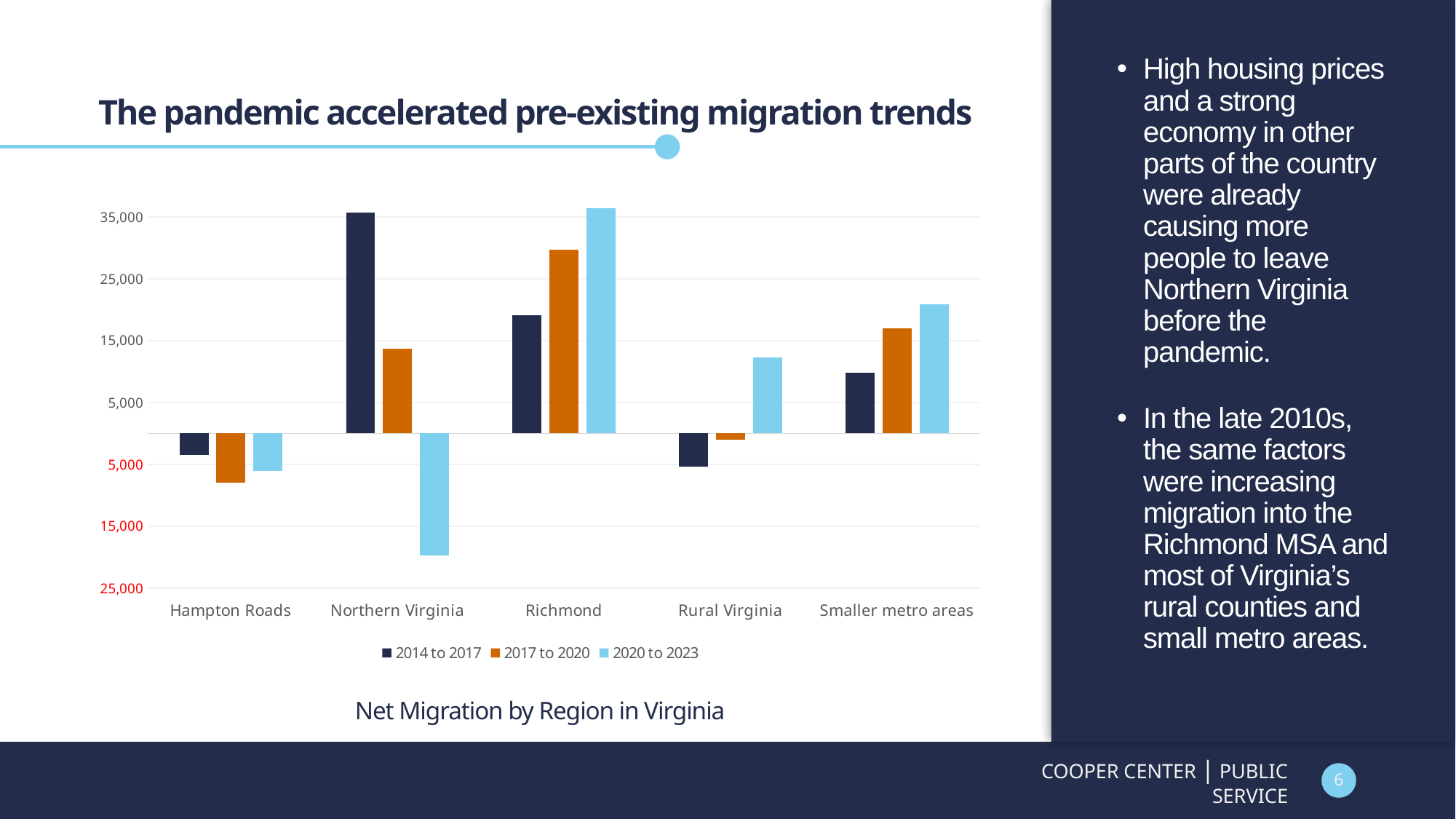
Which region has the lowest value for the 2020 to 2023 series? Northern Virginia What is the title shown below the chart? Net Migration by Region in Virginia Is the 2017 to 2020 value for Richmond greater or less than 25,000? greater Which region has the highest value for the 2014 to 2017 series? Northern Virginia How many series does the chart legend list? 3 Is the 2014 to 2017 value for Northern Virginia greater or less than 25,000? greater Do the values for Richmond rise or fall across the three periods from 2014 to 2017 through 2020 to 2023? rise For Richmond, which series has the larger value: 2014 to 2017 or 2020 to 2023? 2020 to 2023 Which region has the highest value for the 2020 to 2023 series? Richmond What kind of chart is shown on the slide? bar chart Is the 2020 to 2023 value for Smaller metro areas greater or less than 15,000? greater How many regions are shown on the x axis of the chart? 5